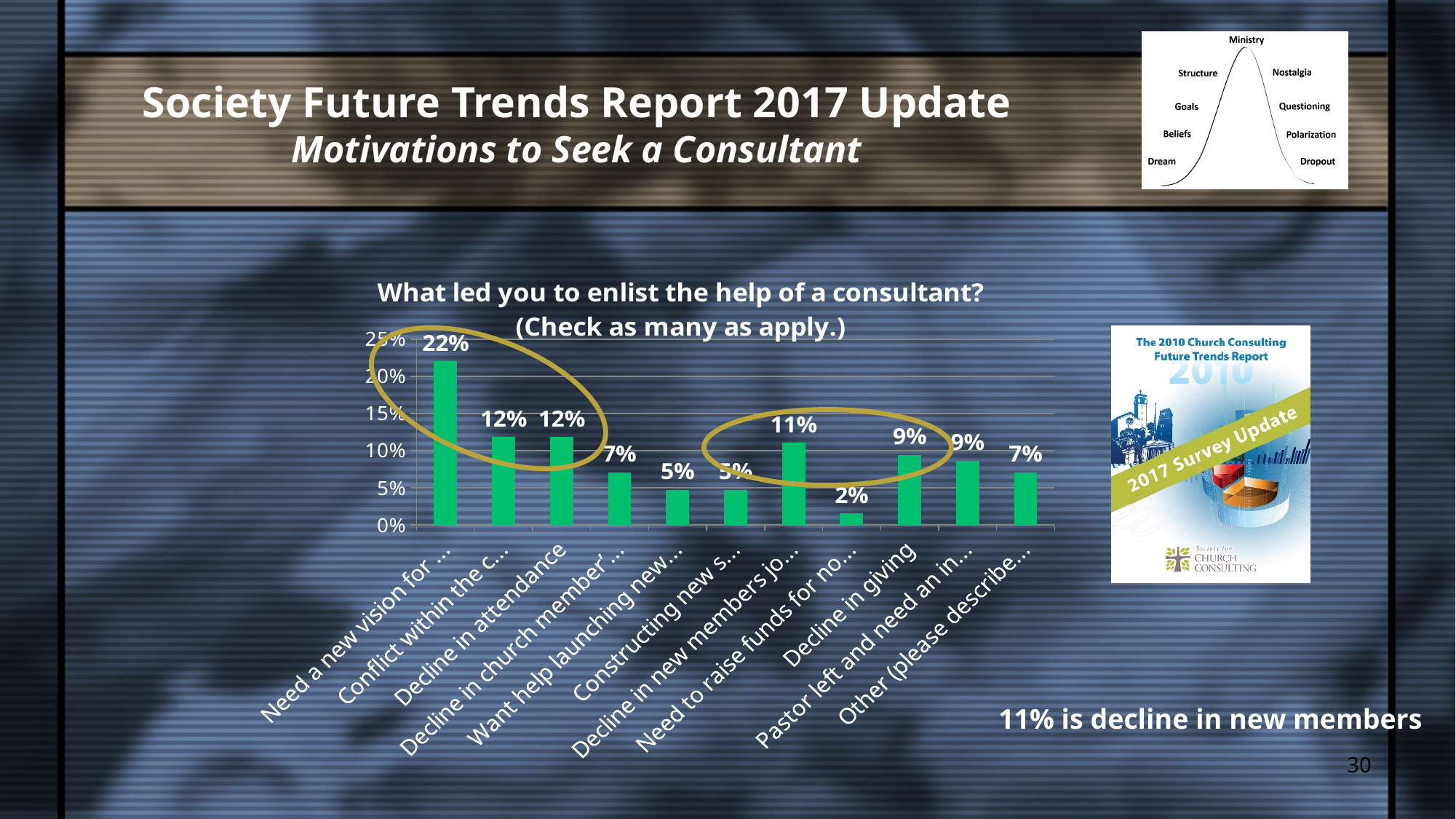
Is the value for "Decline in giving" greater or less than 10%? less What is the value for "Decline in giving"? 9% What kind of chart is shown on the slide? bar chart What is the value for "Decline in attendance"? 12% What is the lowest value shown in the chart? 2% What is the difference between the values for "Decline in attendance" and "Decline in giving"? 3% What colour are the bars in the chart? green What percentage is shown for the "Decline in new members" category? 11% Which is larger, the value for "Decline in attendance" or the value for "Decline in giving"? Decline in attendance Which category has the lowest value? Need to raise funds for no... What is the highest value shown in the chart? 22% How many categories are shown in the chart? 11